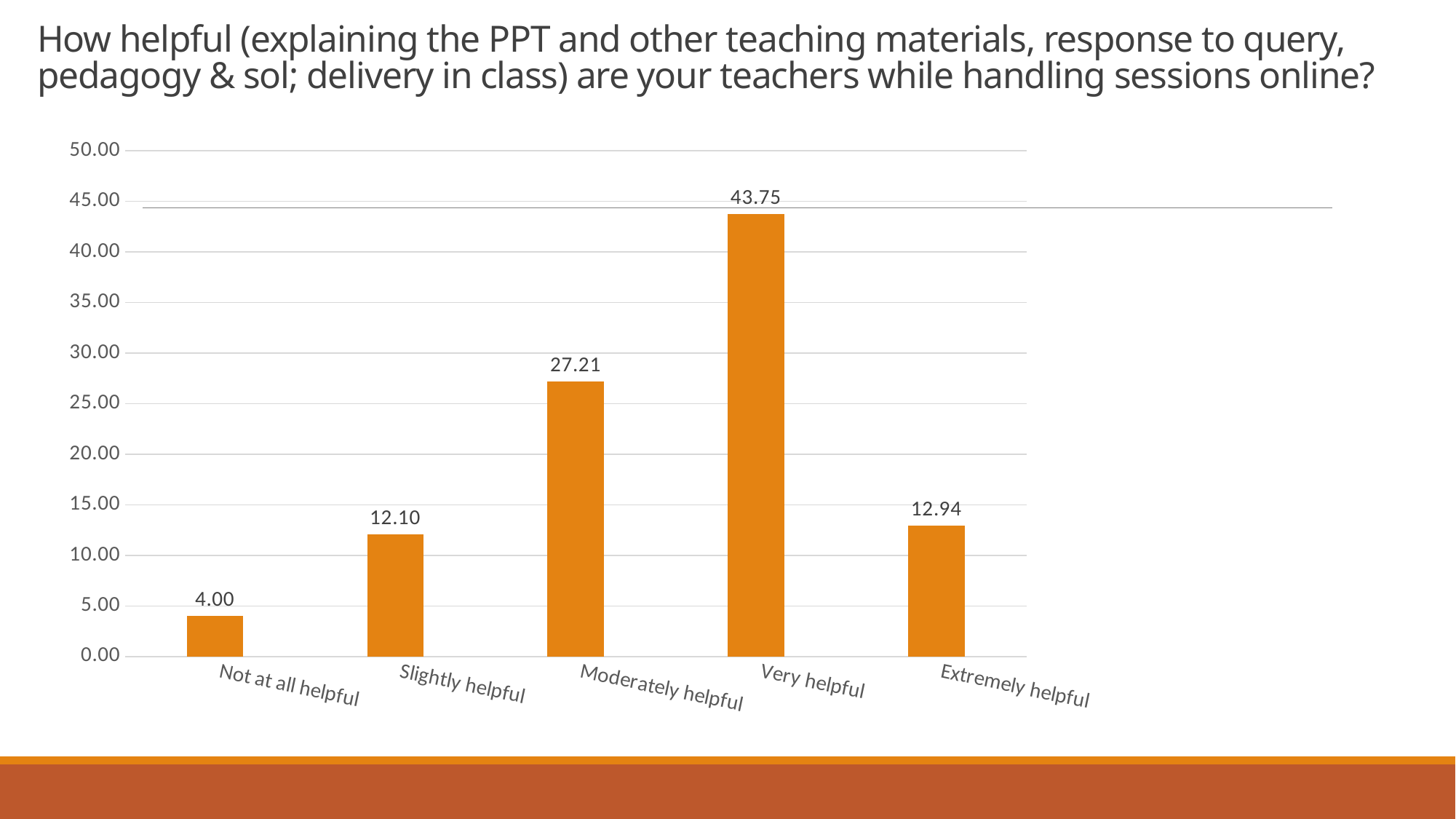
Is the value for Very helpful greater or less than 40.00? greater Which category has the highest value? Very helpful What is the difference between the values for Very helpful and Moderately helpful? 16.54 What is the value for Not at all helpful? 4.00 What kind of chart is shown on the slide? bar chart What is the value for Extremely helpful? 12.94 What is the value for Moderately helpful? 27.21 What is the value for Very helpful? 43.75 Which is larger, the value for Moderately helpful or the value for Extremely helpful? Moderately helpful What is the difference between the values for Extremely helpful and Slightly helpful? 0.84 How many categories are shown on the x axis? 5 Which category has the lowest value? Not at all helpful